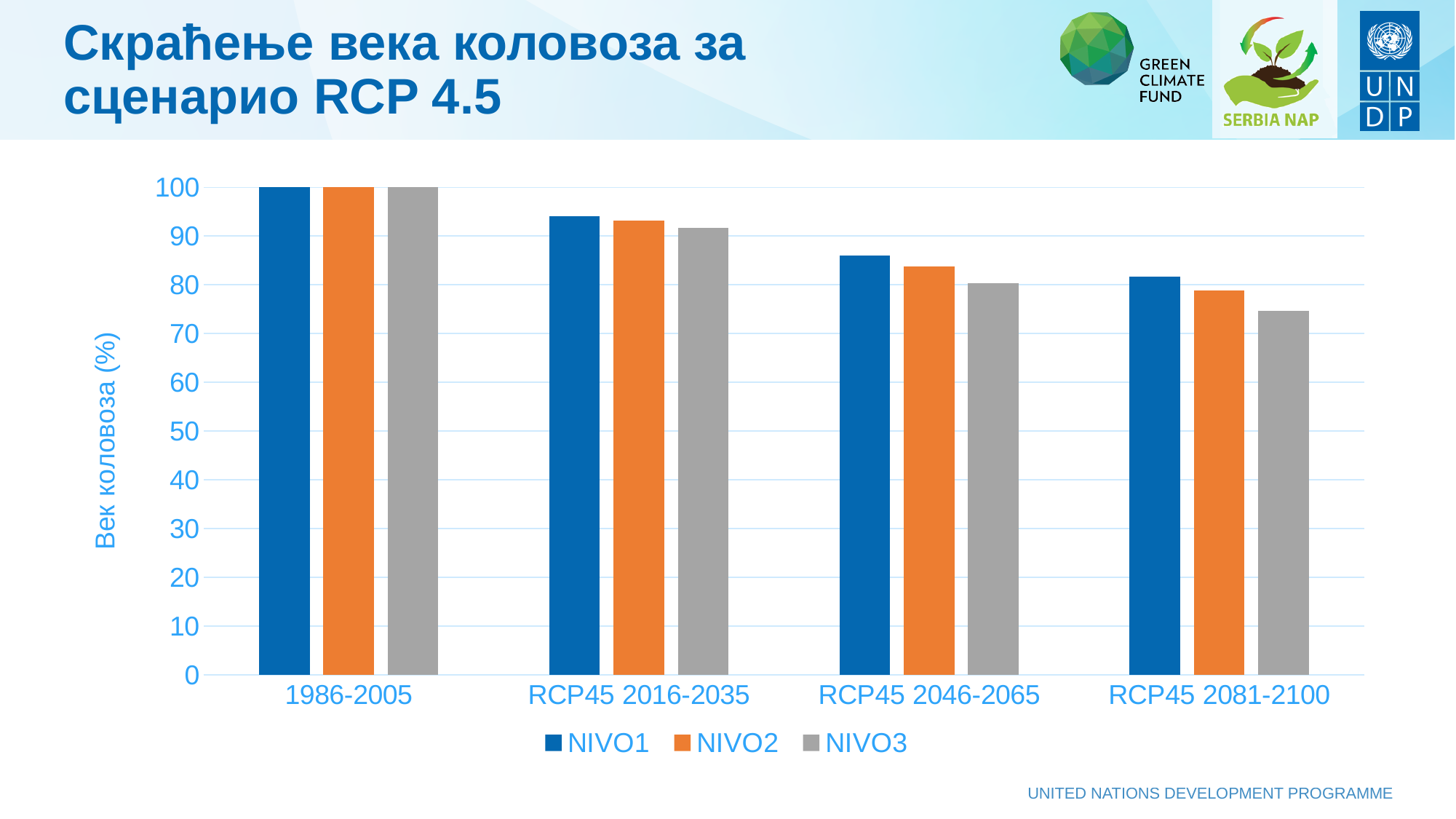
In the RCP45 2081-2100 category, which is larger, NIVO1 or NIVO3? NIVO1 How many categories are shown on the x axis? 4 Do the NIVO3 values rise or fall from left to right along the x axis? fall What is the value for NIVO1 in the 1986-2005 category? 100 What kind of chart is shown on the slide? bar chart Which category has the highest values for all three series? 1986-2005 Is the value for NIVO2 in RCP45 2016-2035 greater or less than 90? greater Is the value for NIVO3 in RCP45 2081-2100 greater or less than 80? less What is the value for NIVO3 in the 1986-2005 category? 100 How many series does the legend list? 3 Which series has the lowest bar in the RCP45 2081-2100 category? NIVO3 Is the value for NIVO1 in RCP45 2046-2065 greater or less than 80? greater